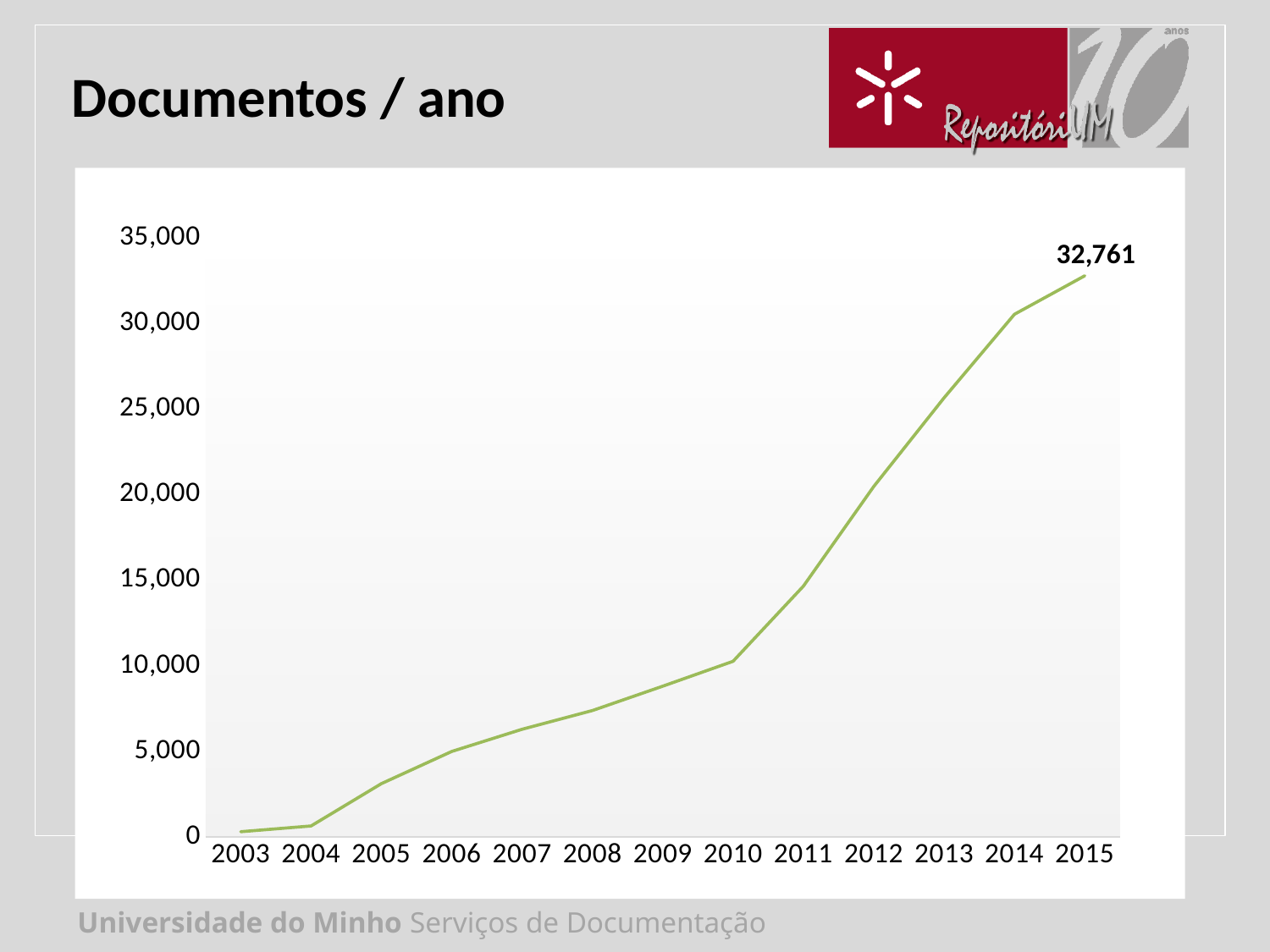
Do the values rise or fall from 2003 to 2015? rise What is the title of the chart? Documentos / ano Is the value for 2008 greater or less than 5,000? greater Which year has the highest value? 2015 Which year has the lowest value? 2003 What kind of chart is shown on the slide? line chart What is the value for 2015? 32,761 Is the value for 2013 greater or less than 30,000? less Which is larger, the value for 2012 or the value for 2010? 2012 Is the value for 2005 greater or less than 5,000? less How many years are plotted on the x axis? 13